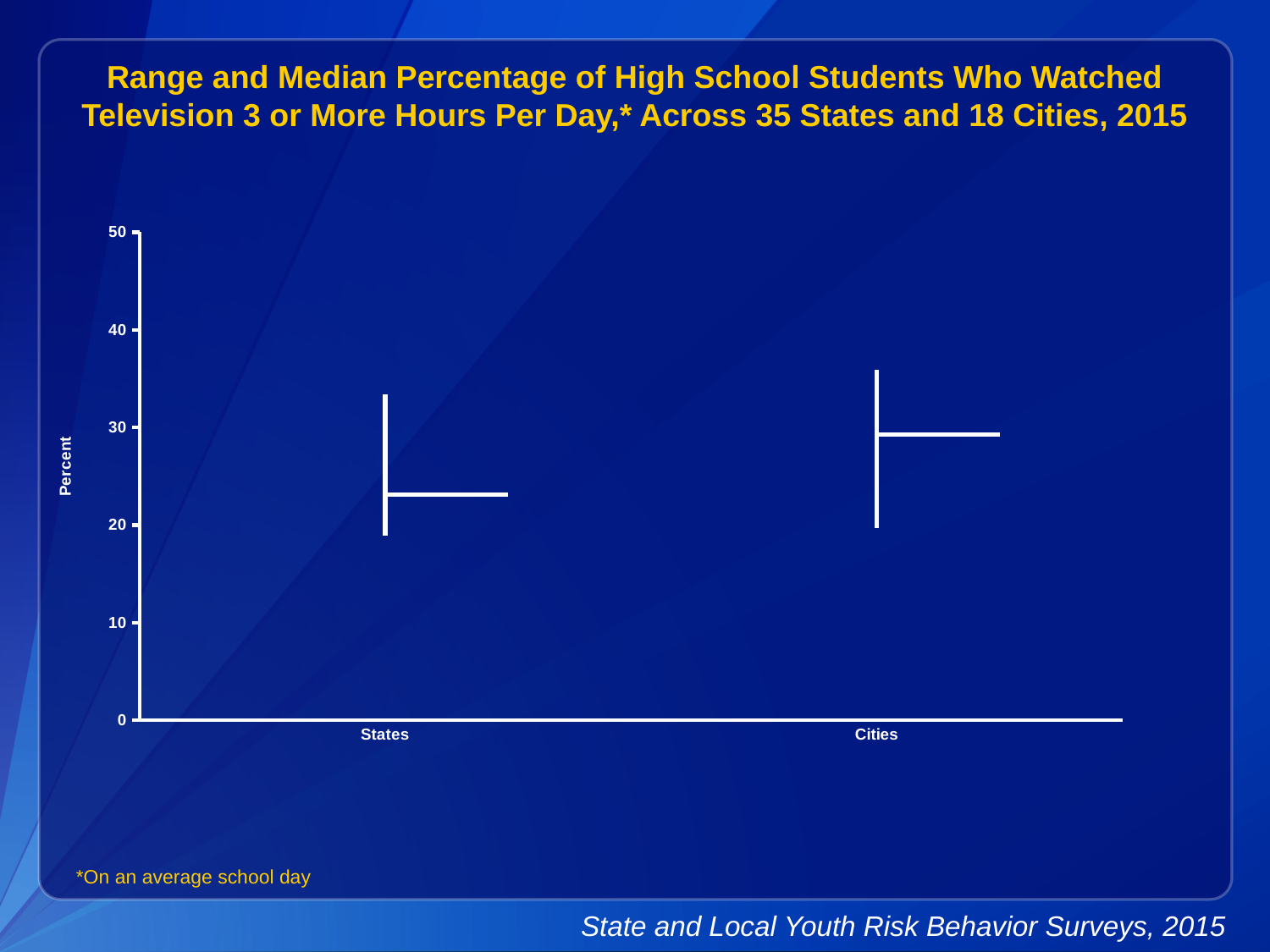
Is the median value for States greater or less than 30? less Which category has the higher median percentage, States or Cities? Cities How many categories are shown on the x axis of the chart? 2 Which category has the higher maximum value in its range, States or Cities? Cities What is the label on the y axis of the chart? Percent What kind of chart is shown on the slide? a range and median (high-low) chart Is the top of the range for States greater or less than 30? greater What is the highest value shown on the y axis? 50 Is the bottom of the range for States greater or less than 10? greater What are the two categories shown on the x axis? States and Cities